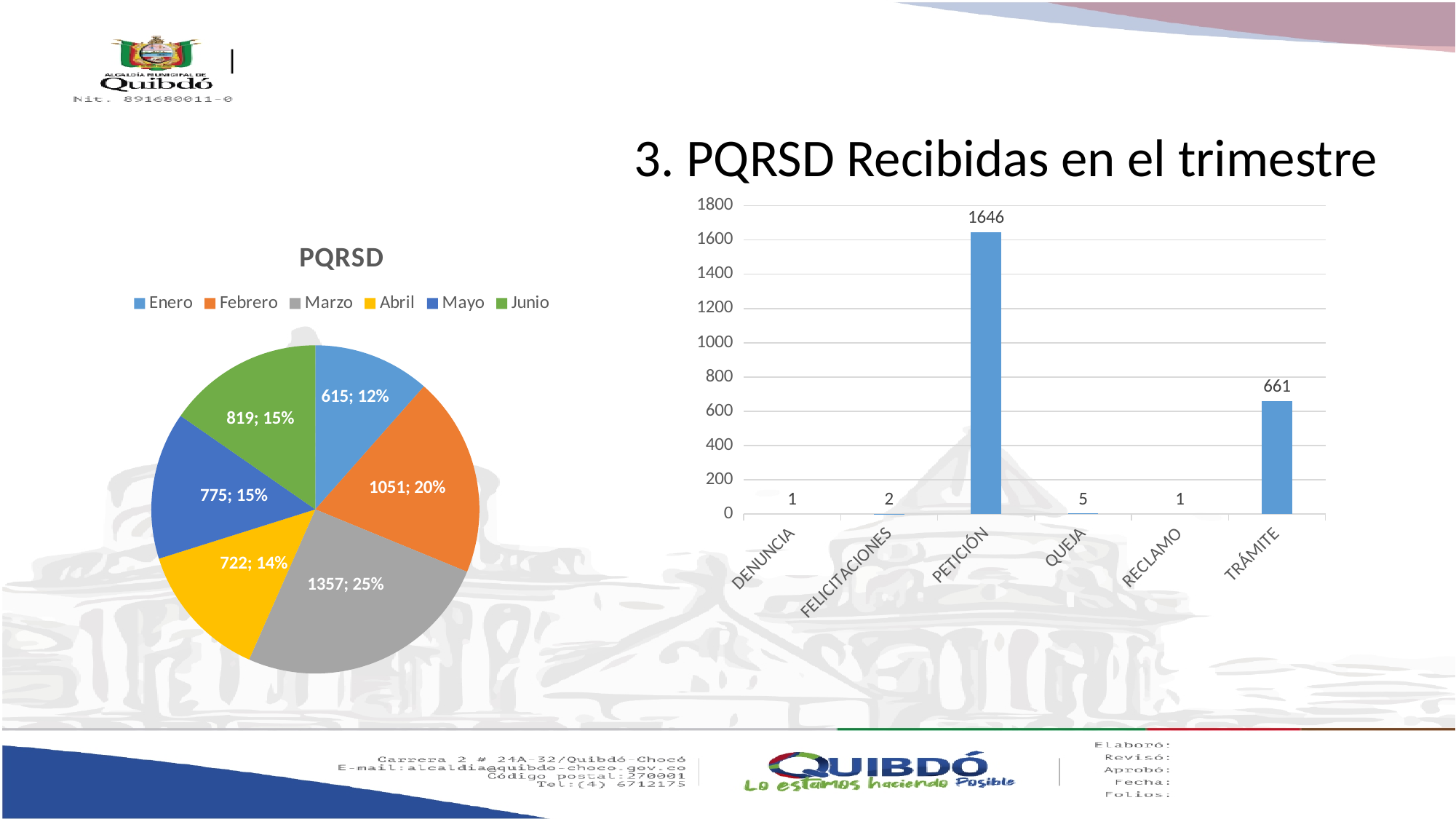
In the bar chart on the right, which category has the highest value? PETICIÓN In the PQRSD pie chart, which month has the largest slice? Marzo In the PQRSD pie chart, what is the difference between the values for Mayo and Abril? 53 How many series does the legend of the PQRSD pie chart list? 6 In the bar chart on the right, what is the difference between PETICIÓN and TRÁMITE? 985 In the bar chart on the right, how many categories are shown on the x axis? 6 In the bar chart on the right, what is the value for TRÁMITE? 661 What type of chart is the chart on the right side of the slide? Bar chart In the PQRSD pie chart, which month has the smallest slice? Enero In the PQRSD pie chart, what share of the pie does Febrero represent? 20% In the PQRSD pie chart, what is the value for Marzo? 1357 In the bar chart on the right, what is the value for PETICIÓN? 1646